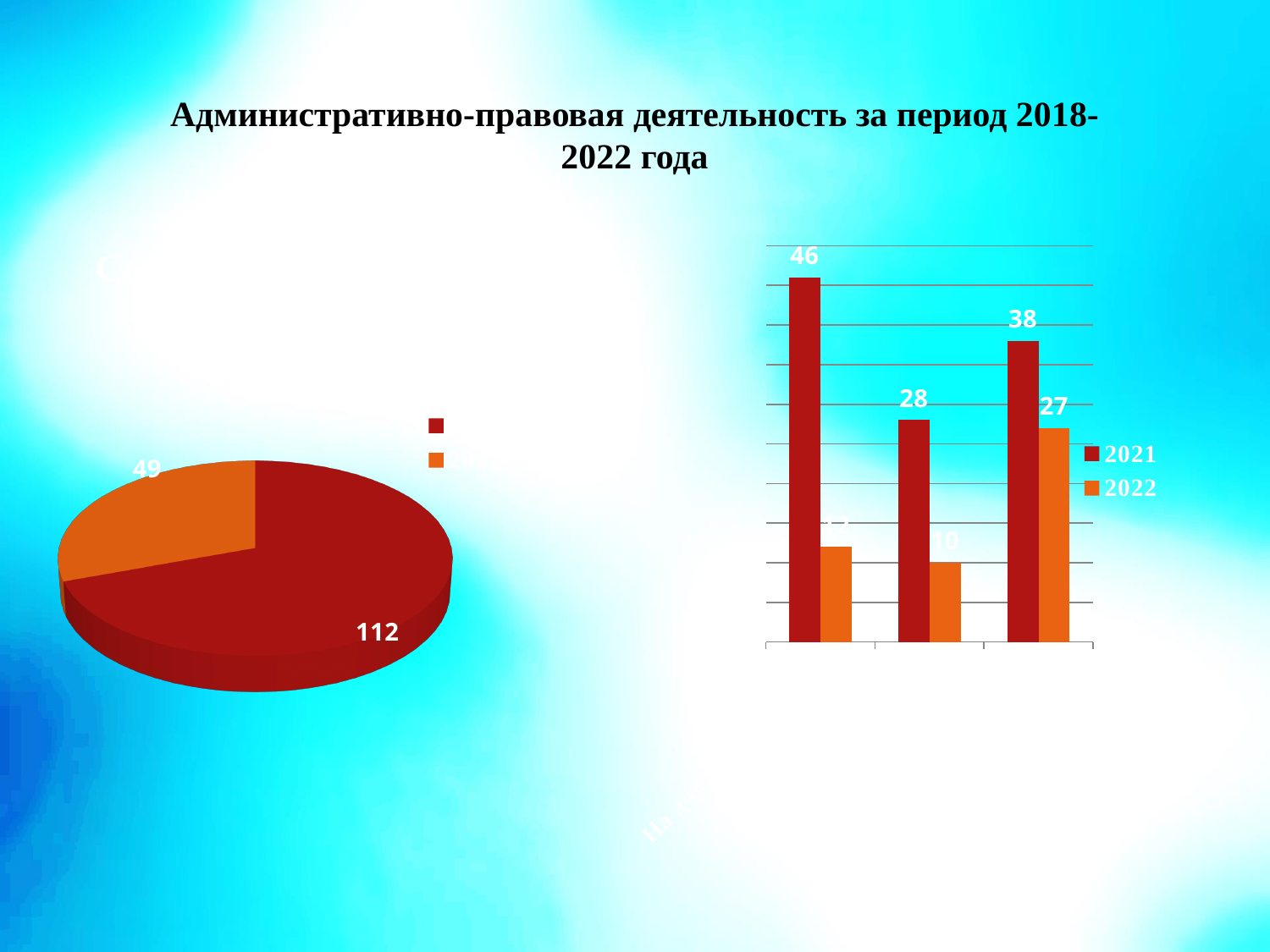
How many series does the legend of the bar chart on the right list? 2 In the bar chart on the right, what is the 2021 value for the third (rightmost) group of bars? 38 What kind of chart is the chart on the right of the slide? bar chart What are the legend entries of the bar chart on the right? 2021, 2022 In the bar chart on the right, what is the highest value of the 2021 series? 46 In the pie chart on the left, what is the value of the smaller (orange) slice? 49 In the bar chart on the right, what is the difference between the 2021 and 2022 values in the third (rightmost) group of bars? 11 In the pie chart on the left, what is the value of the larger (dark red) slice? 112 What kind of chart is the chart on the left of the slide? pie chart How many slices does the pie chart on the left have? 2 In the bar chart on the right, what is the 2022 value for the third (rightmost) group of bars? 27 In the pie chart on the left, what is the difference between the two slice values? 63